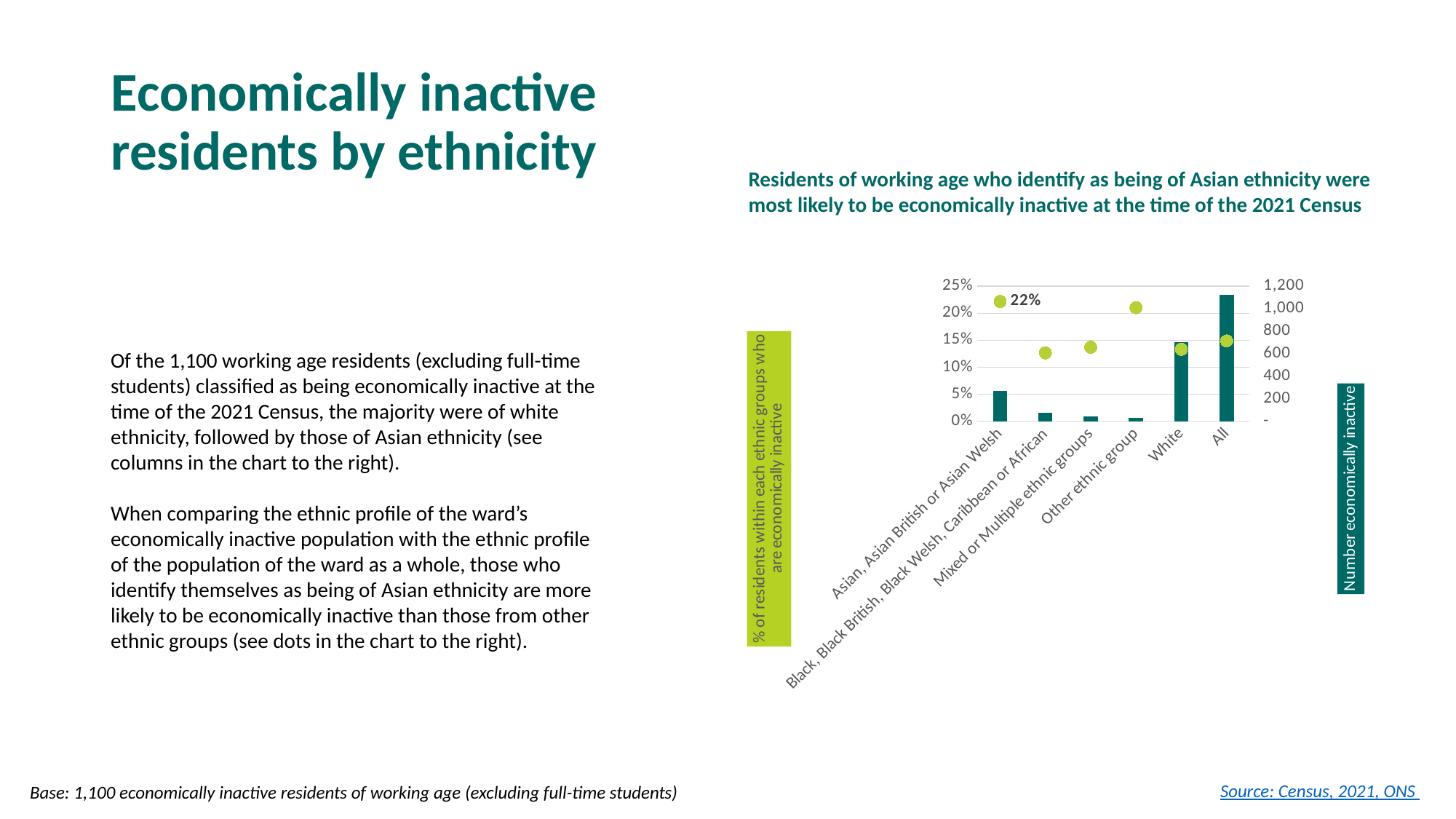
Which category has the highest dot (percentage economically inactive) in the chart? Asian, Asian British or Asian Welsh How many ethnic group categories are shown along the x axis of the chart? 6 Which has the larger number economically inactive: the White group or the Asian, Asian British or Asian Welsh group? White What kind of chart is shown on the slide? Bar chart with dot markers Excluding the 'All' category, which ethnic group has the tallest bar for number economically inactive? White Is the number economically inactive for the 'All' bar greater or less than 1,000? greater Which category has the tallest bar (largest number economically inactive) in the chart? All Is the percentage economically inactive for the Black, Black British, Black Welsh, Caribbean or African group greater or less than 15%? less Is the number economically inactive for the White group greater or less than 400? greater What is the label on the right-hand vertical axis of the chart? Number economically inactive What percentage of residents in the Asian, Asian British or Asian Welsh group are economically inactive, according to the data label on the chart? 22%